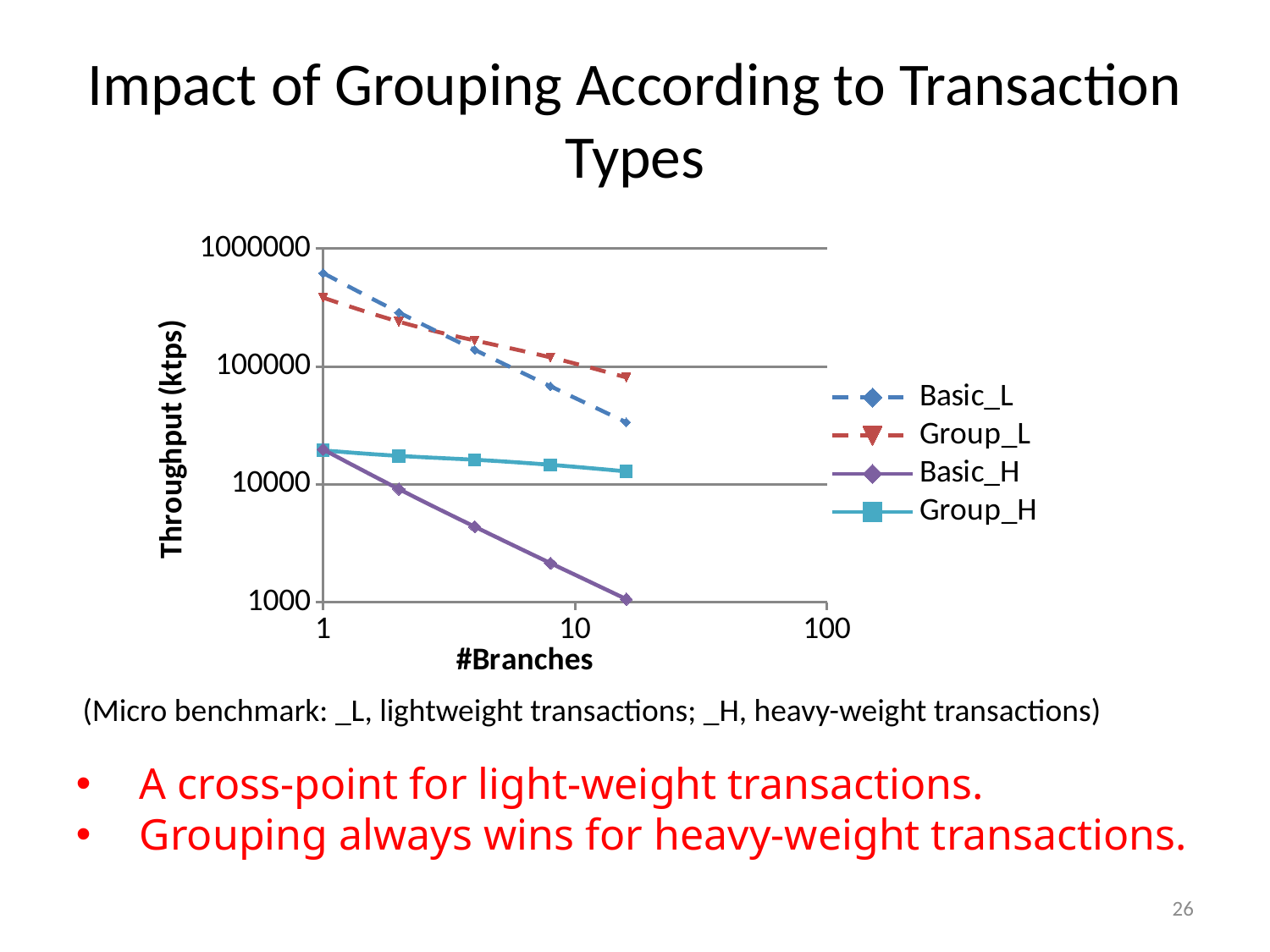
Is the throughput of Basic_L at 16 branches greater or less than 100000? less Is the throughput of Basic_H at 1 branch greater or less than 10000? greater How many data points are plotted for the Basic_H series? 5 At 1 branch, which has higher throughput, Basic_L or Group_L? Basic_L What kind of chart is shown on the slide? line chart What is the label of the vertical axis? Throughput (ktps) How many series does the legend list? 4 At 16 branches, which has higher throughput, Basic_L or Group_L? Group_L Does the throughput of Basic_H rise or fall as #Branches increases? fall Which series has the lowest throughput at 16 branches? Basic_H Is the throughput of Basic_L at 1 branch greater or less than 100000? greater